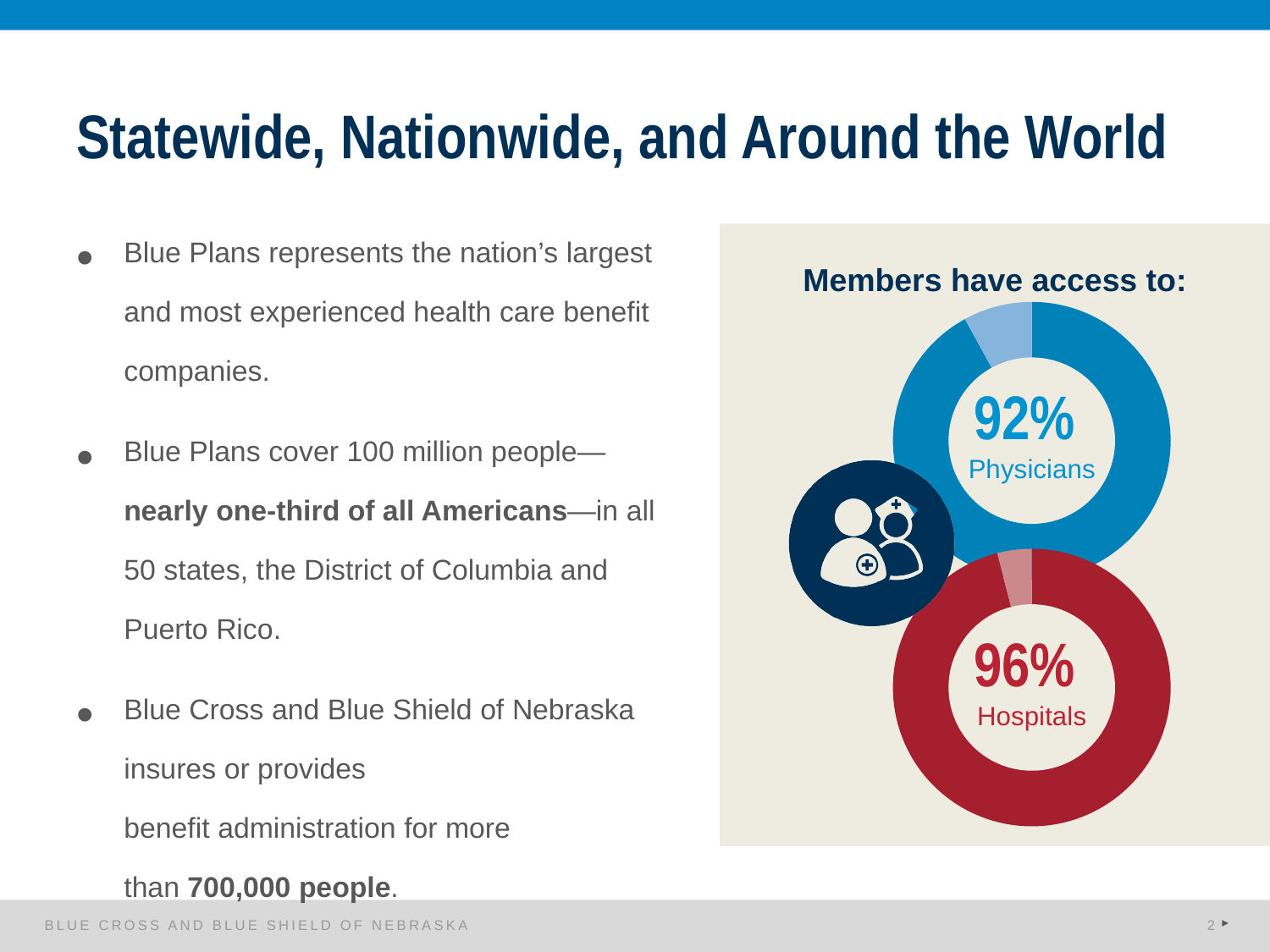
What is the heading above the donut charts? Members have access to: What colour is the Hospitals donut chart? Red Is the Physicians value greater or less than 90%? greater Which is higher: the percentage for Physicians or the percentage for Hospitals? Hospitals What is the difference in percentage points between the Hospitals value and the Physicians value? 4 Which of the two donut charts shows the lower percentage? Physicians What kind of chart is used to show the Physicians and Hospitals percentages? Donut (pie) chart What percentage of physicians do members have access to according to the top donut chart? 92% Which of the two donut charts shows the higher percentage? Hospitals What share of the Hospitals donut is not filled by the 96% segment? 4% What percentage of hospitals do members have access to according to the bottom donut chart? 96% How many donut charts are shown on the slide? 2